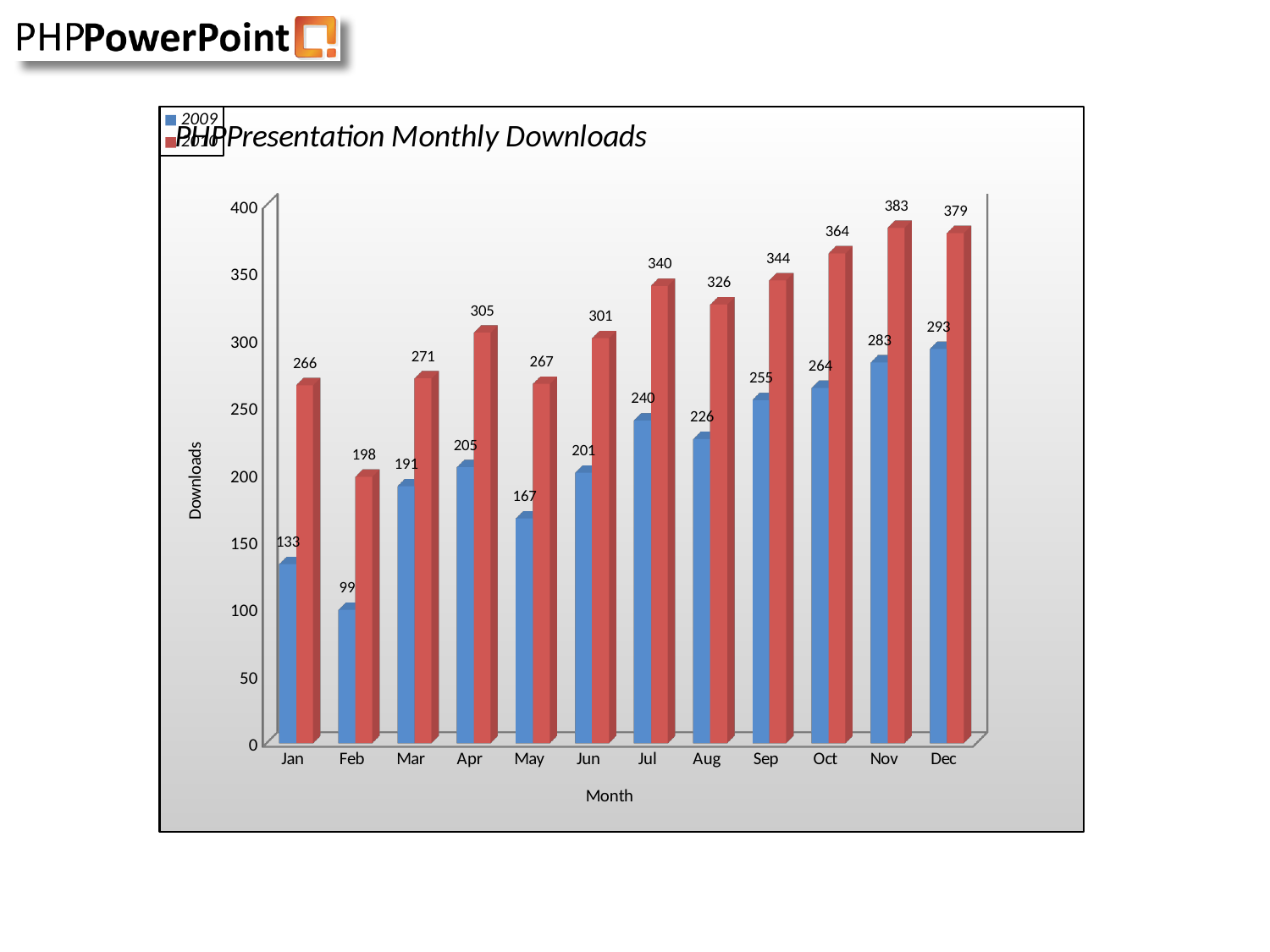
What is the difference between the 2010 and 2009 values for Jan? 133 Which month has the lowest 2009 value? Feb How many months are shown on the x axis? 12 What is the 2009 value for Jul? 240 What kind of chart is shown? bar chart Which month has the highest 2010 value? Nov Which is larger, the 2009 value for Dec or the 2010 value for Feb? 2009 value for Dec How many series does the legend list? 2 What is the 2010 value for Apr? 305 Do the 2010 values generally rise or fall from Jan to Dec? rise Is the 2010 value for Sep greater or less than 300? greater What is the title of the chart? PHPPresentation Monthly Downloads